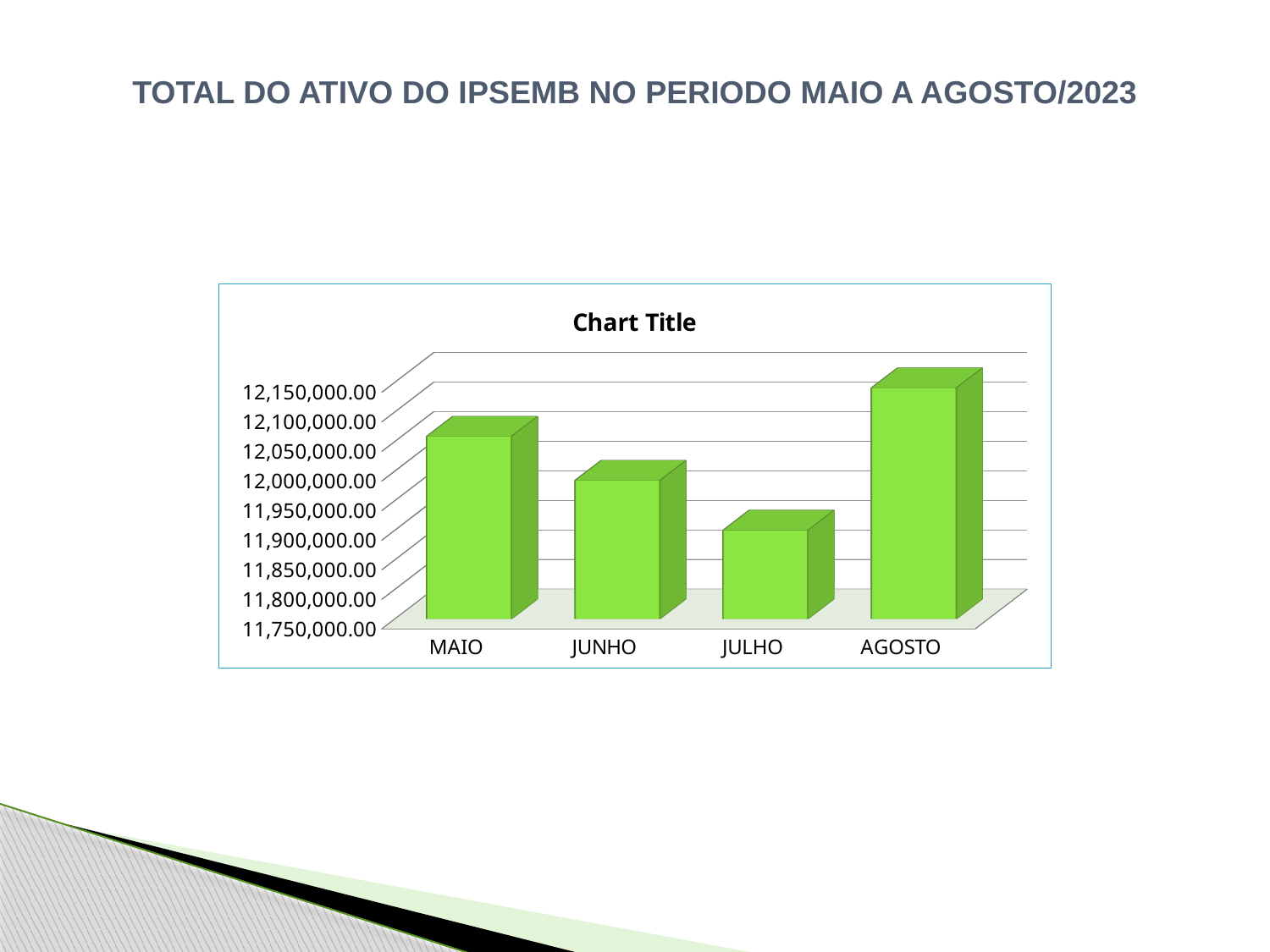
Do the values rise or fall from MAIO to JULHO? fall How many categories (months) are plotted on the chart? 4 Is the value for AGOSTO greater or less than 12,100,000.00? greater What title is printed inside the chart area? Chart Title Is the value for JULHO greater or less than 12,000,000.00? less Which is larger, the value for MAIO or the value for JUNHO? MAIO Which is larger, the value for JULHO or the value for AGOSTO? AGOSTO Is the value for MAIO greater or less than 12,000,000.00? greater Which month has the lowest value on the chart? JULHO Which month has the highest value on the chart? AGOSTO What kind of chart is shown on the slide? bar chart